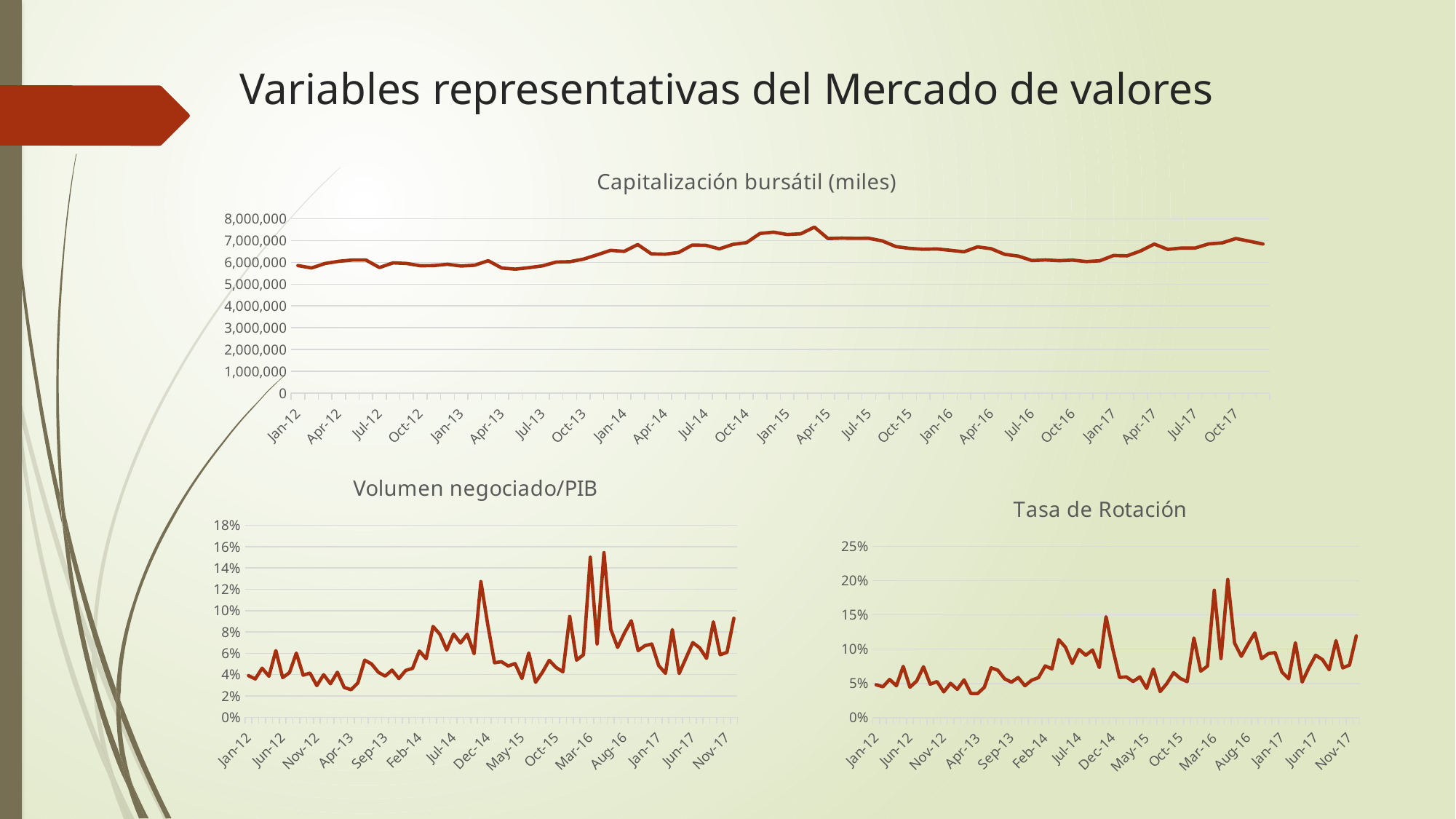
What kind of chart is the 'Capitalización bursátil (miles)' chart? line chart In the 'Tasa de Rotación' chart, is the highest peak (around Apr-16) greater or less than 15%? greater What kind of chart is the 'Tasa de Rotación' chart? line chart How many charts are shown on the slide? 3 What is the highest value shown on the vertical axis of the 'Tasa de Rotación' chart? 25% In the 'Capitalización bursátil (miles)' chart, is the highest value (around Apr-15) greater or less than 7,000,000? greater In the 'Volumen negociado/PIB' chart, is the value for Jan-12 greater or less than 6%? less What is the title of the chart at the bottom left of the slide? Volumen negociado/PIB In the 'Capitalización bursátil (miles)' chart, does the line rise or fall overall between Jan-12 and Apr-15? rise